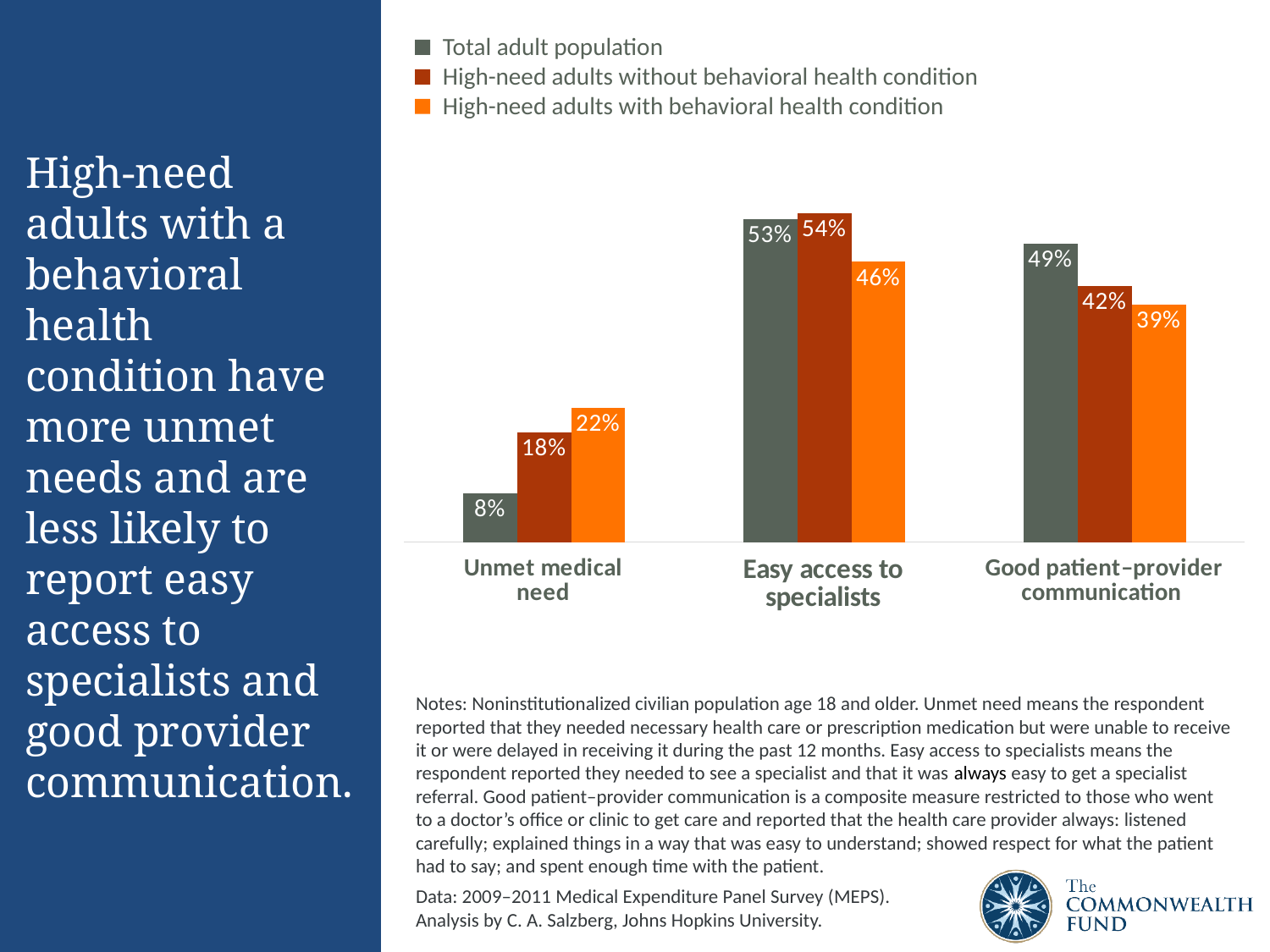
How many categories are shown on the x axis? 3 What kind of chart is shown on the slide? Bar chart What is the value for Total adult population for Easy access to specialists? 53% Which is larger for Good patient–provider communication: Total adult population or High-need adults with behavioral health condition? Total adult population Which category has the lowest value for Total adult population? Unmet medical need What is the value for High-need adults without behavioral health condition for Good patient–provider communication? 42% How many series does the legend list? 3 What is the difference between High-need adults without behavioral health condition and High-need adults with behavioral health condition for Easy access to specialists? 8% What is the difference between Total adult population and High-need adults with behavioral health condition for Unmet medical need? 14% Which legend entry is shown in orange? High-need adults with behavioral health condition Which series has the highest value for Good patient–provider communication? Total adult population What is the value for High-need adults with behavioral health condition for Unmet medical need? 22%